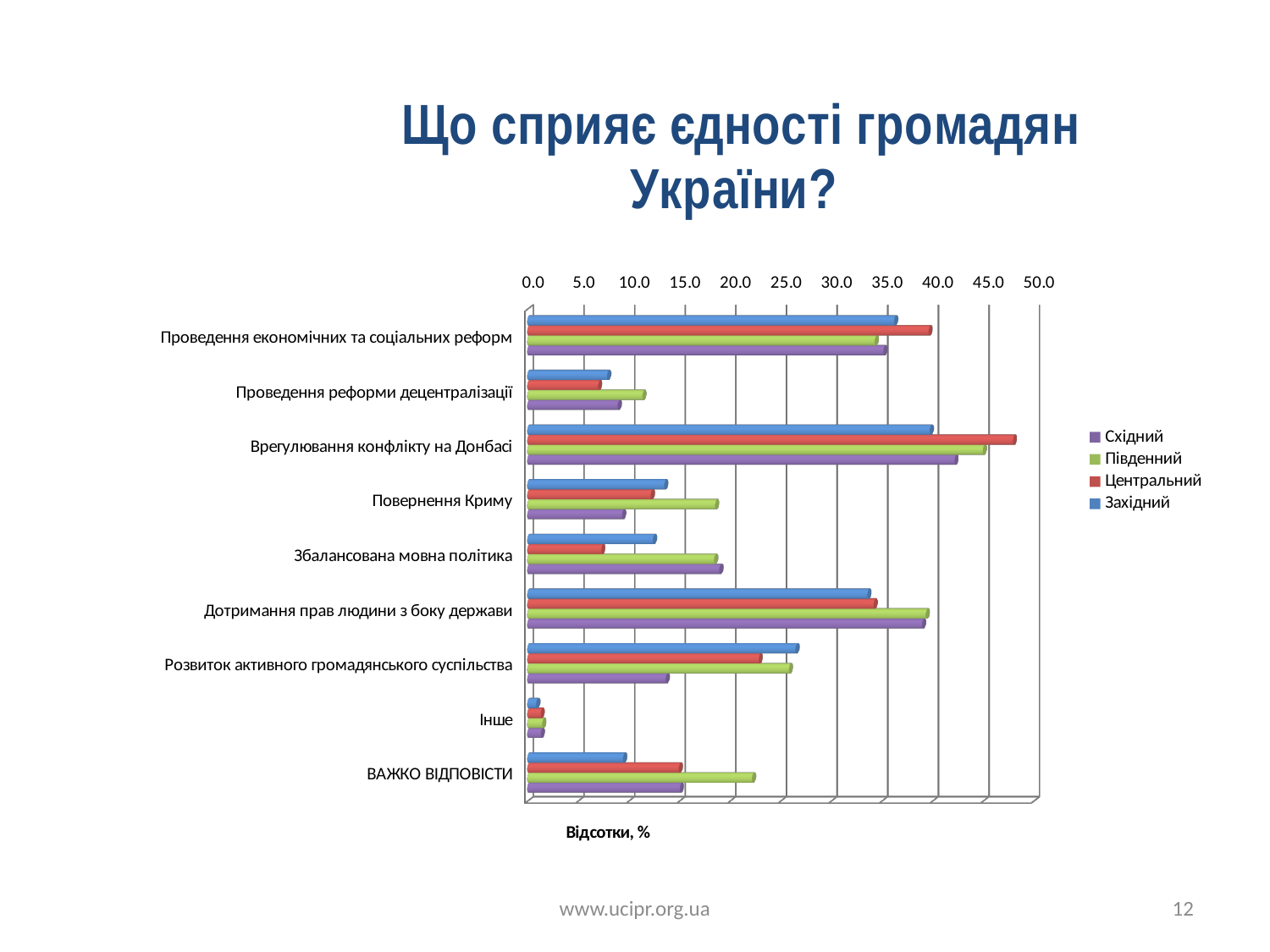
For Повернення Криму, which is larger: the Південний value or the Східний value? Південний Which category has the highest Центральний value? Врегулювання конфлікту на Донбасі How many categories are listed on the vertical axis of the chart? 9 Is the Південний value for ВАЖКО ВІДПОВІСТИ greater or less than 20.0? greater Is the Центральний value for Проведення економічних та соціальних реформ greater or less than 35.0? greater Is the Центральний value for Збалансована мовна політика greater or less than 10.0? less What kind of chart is shown on the slide? Bar chart Which category has the lowest values across all four series? Інше How many series does the chart legend list? 4 What is the title of the slide containing the chart? Що сприяє єдності громадян України? What is the label of the horizontal axis of the chart? Відсотки, %